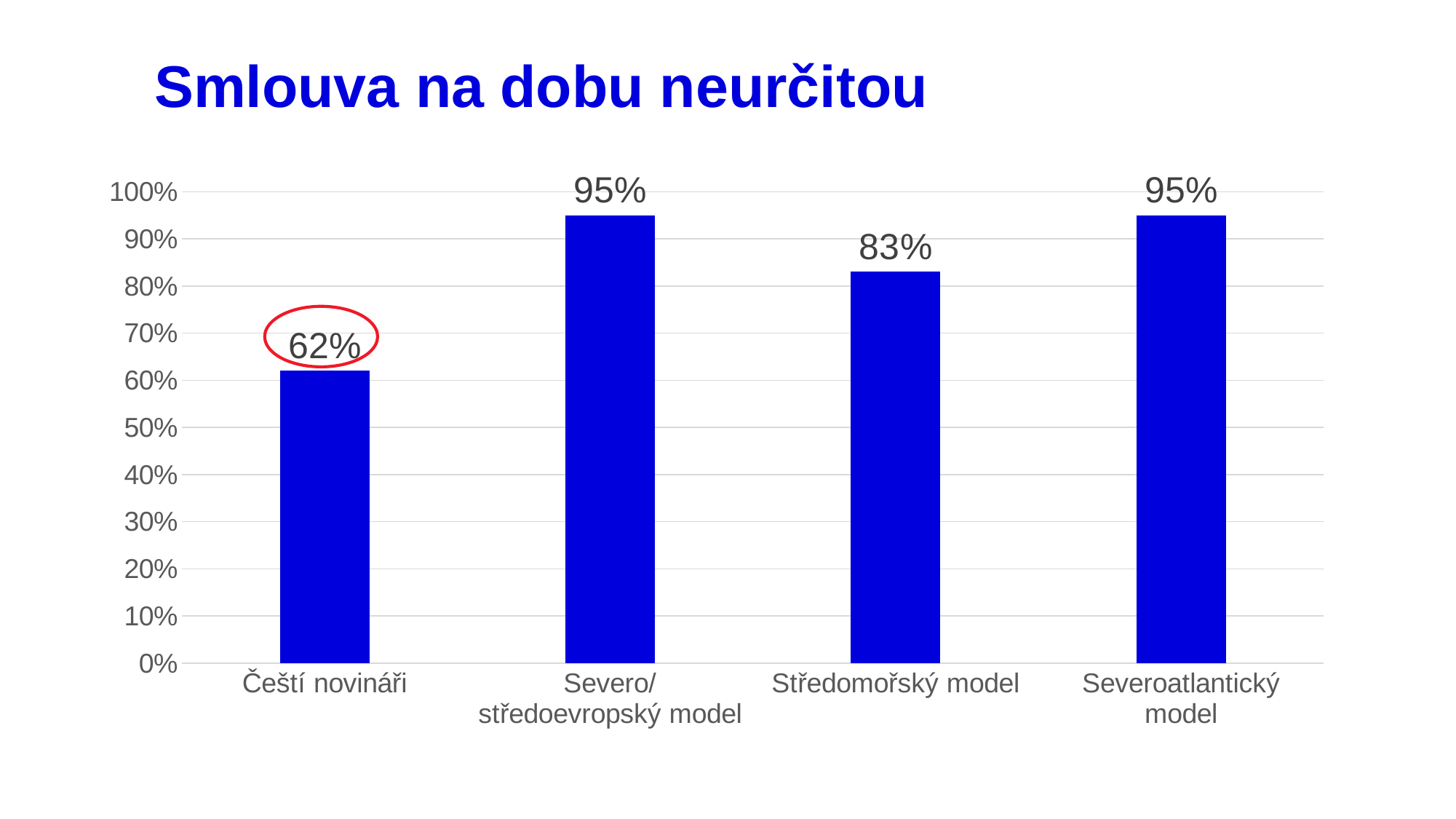
What is the difference between the values for Severoatlantický model and Čeští novináři? 33% What kind of chart is shown on the slide? bar chart How many categories are shown in the chart? 4 Which is larger, the value for Středomořský model or the value for Severoatlantický model? Severoatlantický model What is the value for Čeští novináři? 62% What is the value for Severo/středoevropský model? 95% What is the value for Středomořský model? 83% Is the value for Čeští novináři greater or less than 70%? less Which category has the lowest value? Čeští novináři What is the title of the slide? Smlouva na dobu neurčitou What is the value for Severoatlantický model? 95% What is the difference between the values for Středomořský model and Čeští novináři? 21%